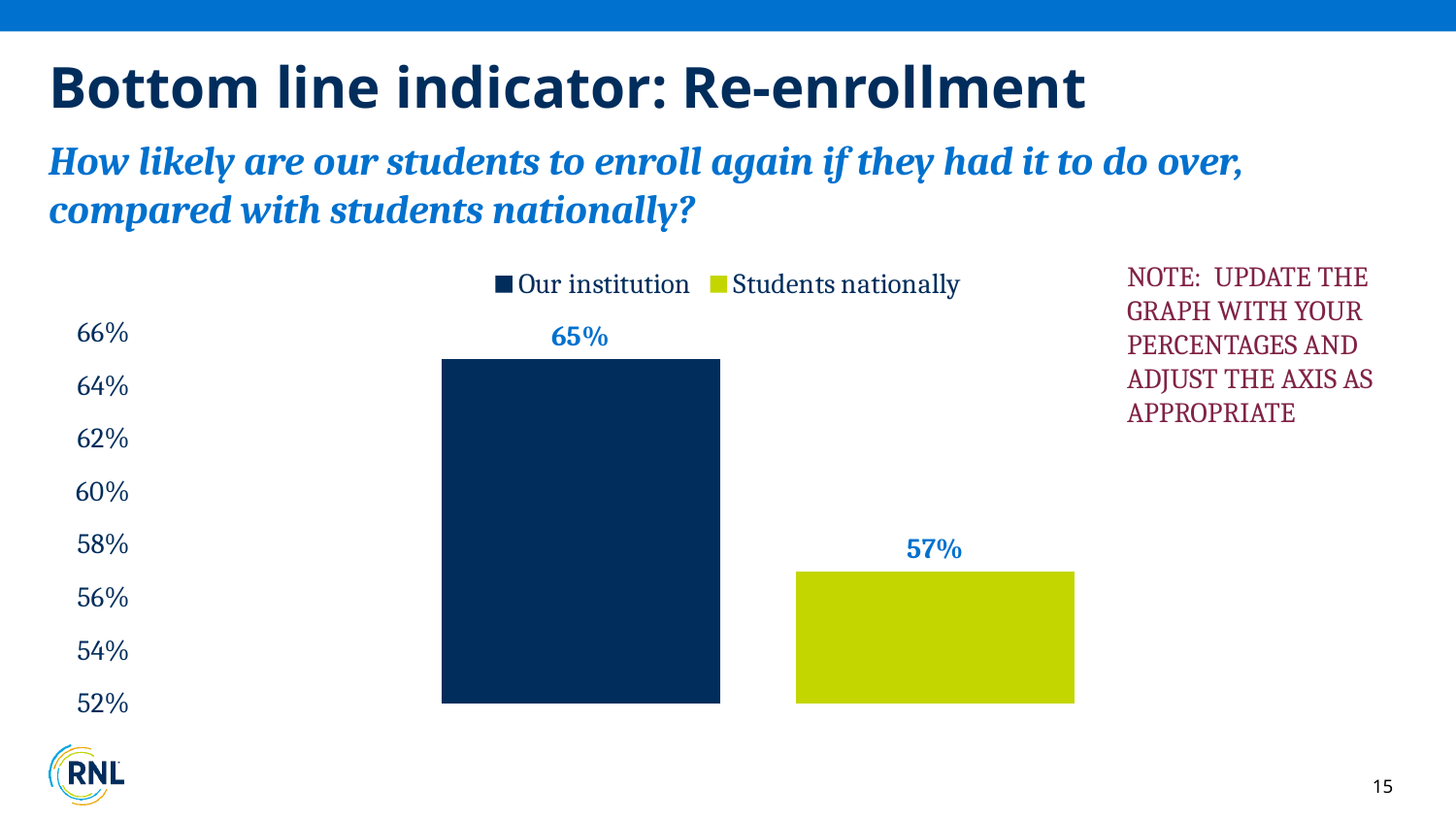
How many series does the legend list? 2 What colour is the bar for Students nationally? Yellow-green What is the value for Our institution? 65% What kind of chart is shown on the slide? Bar chart What is the value for Students nationally? 57% Which series has the higher value, Our institution or Students nationally? Our institution How many bars are plotted in the chart? 2 What is the difference between the value for Our institution and the value for Students nationally? 8% Is the value for Our institution greater or less than 62%? greater Is the value for Students nationally greater or less than 60%? less Which series has the highest value? Our institution Which series has the lowest value? Students nationally